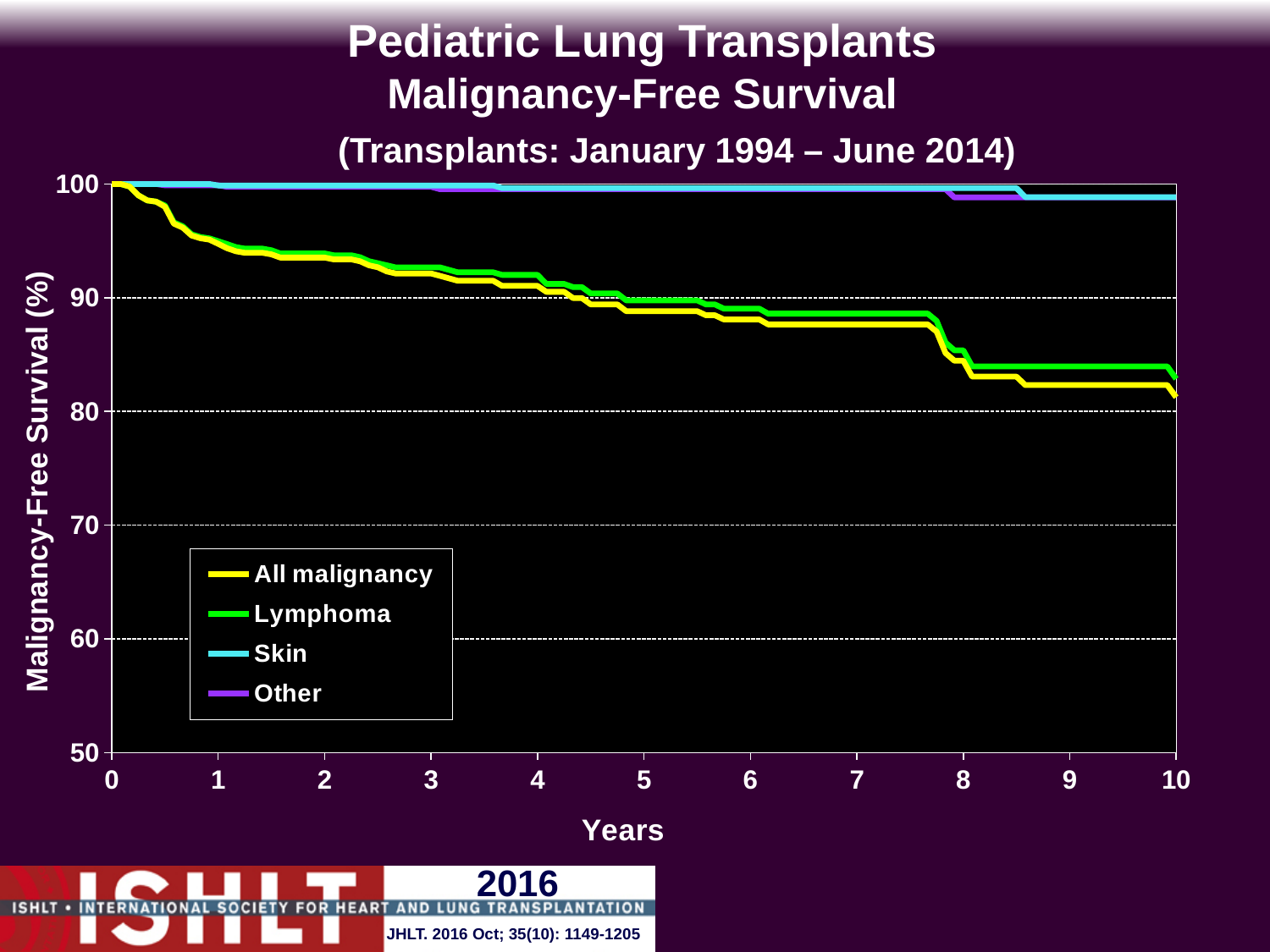
What is the label of the y axis? Malignancy-Free Survival (%) How many series does the legend list? 4 What colour is the Lymphoma line in the legend? Green Is the All malignancy value at year 2 greater or less than 90? greater What kind of chart is shown on the slide? Line chart Is the Lymphoma value at year 10 greater or less than 80? greater Which series has the lowest malignancy-free survival at year 10? All malignancy Is the Skin value at year 10 greater or less than 90? greater Does the All malignancy curve rise or fall as years increase? Fall At year 10, which is higher: the Lymphoma curve or the All malignancy curve? Lymphoma